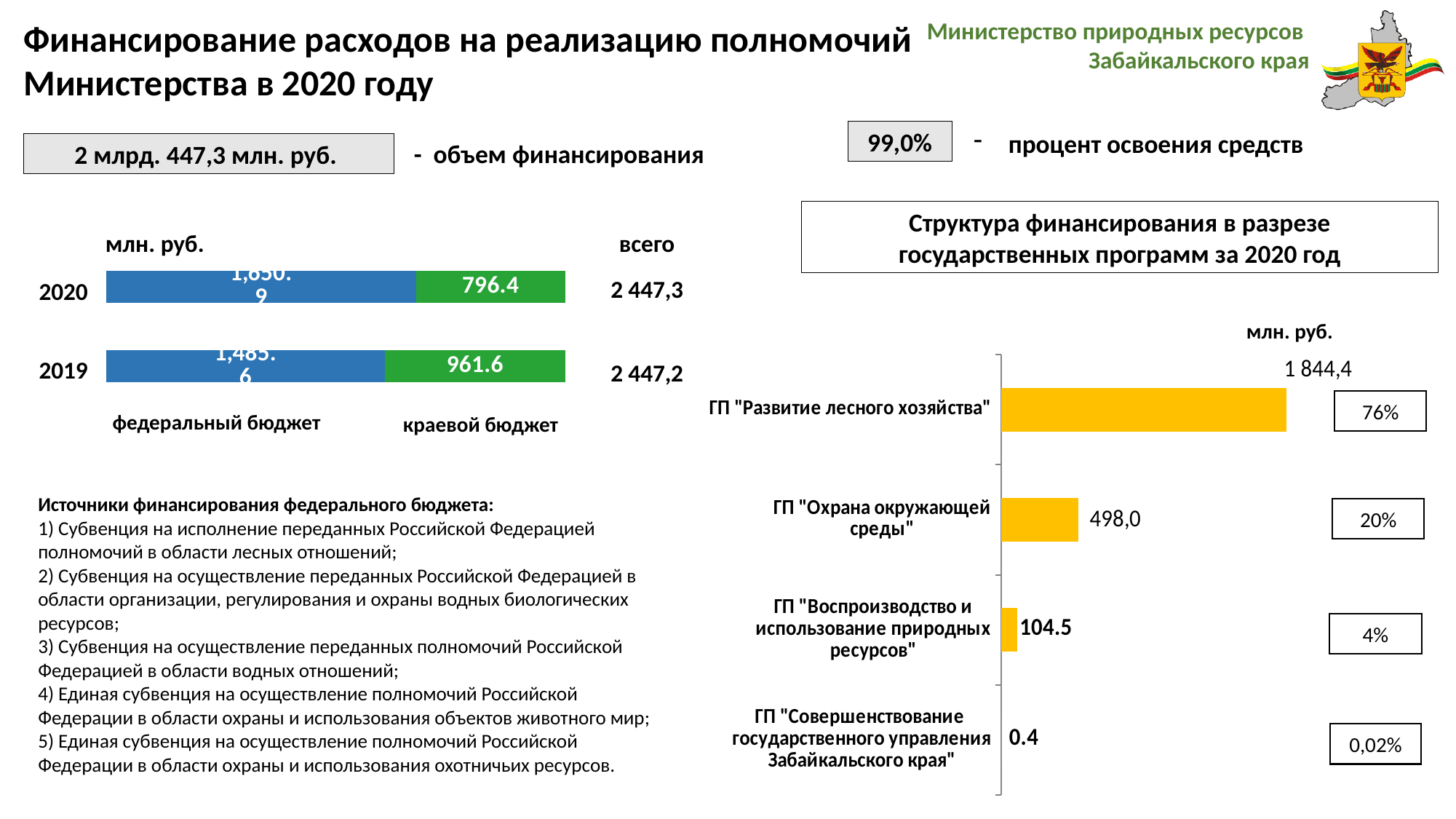
In the left chart, which series is larger in 2020: the federal budget or the regional budget? федеральный бюджет In the left chart, what is the value of the regional budget (краевой бюджет) for 2020? 796.4 In the left chart, what is the total (всего) shown for 2019? 2 447,2 In the left chart, by how much did the regional budget (краевой бюджет) decrease from 2019 to 2020? 165.2 What kind of chart is 'Структура финансирования в разрезе государственных программ за 2020 год'? bar chart In the left chart, how many series does the legend list? 2 In the chart 'Структура финансирования в разрезе государственных программ за 2020 год', which program has the lowest value? ГП "Совершенствование государственного управления Забайкальского края" In the chart 'Структура финансирования в разрезе государственных программ за 2020 год', what is the value for ГП "Развитие лесного хозяйства"? 1 844,4 In the left chart, what is the value of the regional budget (краевой бюджет) for 2019? 961.6 In the chart 'Структура финансирования в разрезе государственных программ за 2020 год', what is the value for ГП "Охрана окружающей среды"? 498,0 In the left chart, what is the total (всего) shown for 2020? 2 447,3 In the chart 'Структура финансирования в разрезе государственных программ за 2020 год', what share does ГП "Воспроизводство и использование природных ресурсов" have? 4%